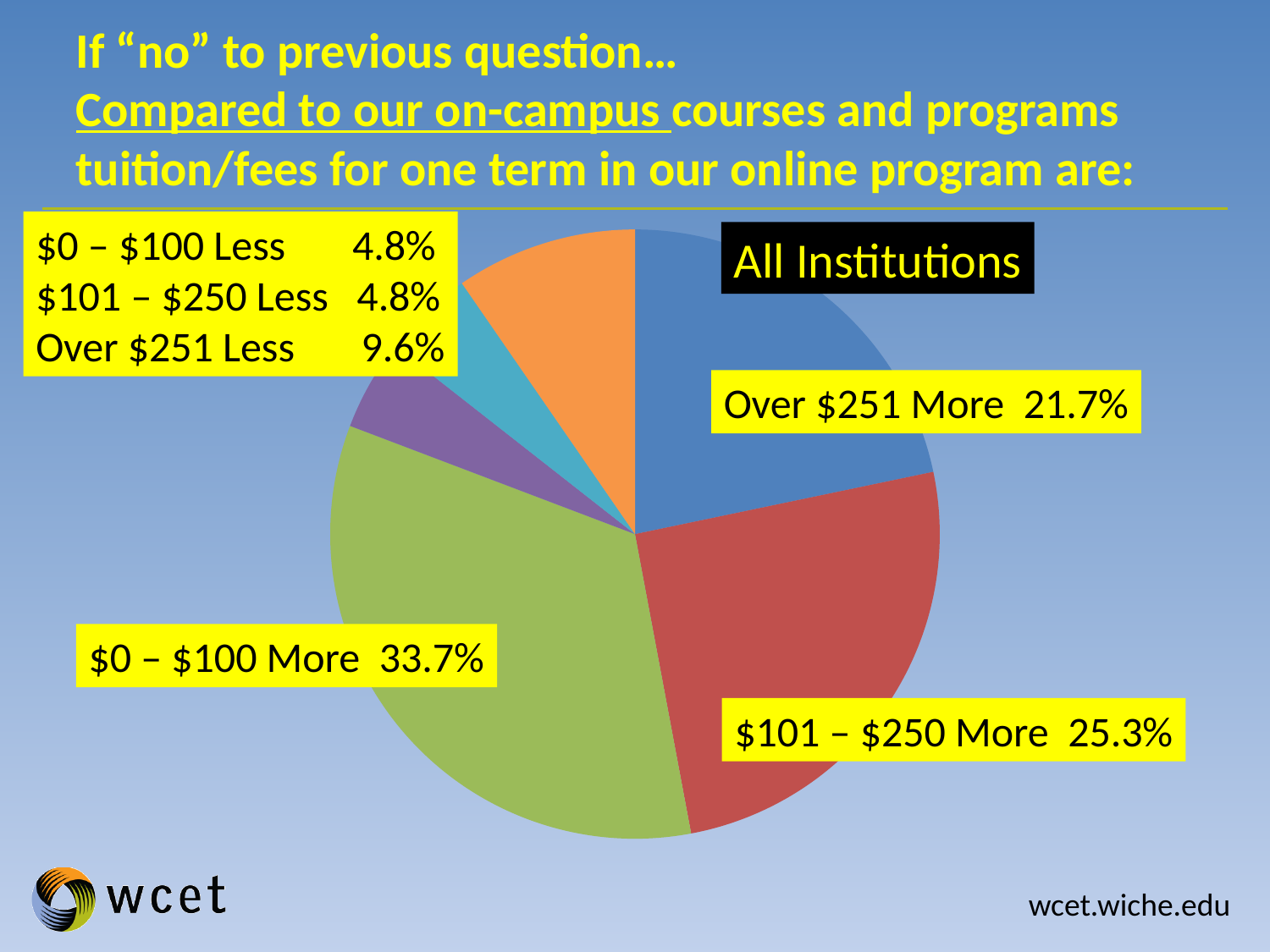
How many categories are shown in the pie chart? 6 What type of chart is shown on the slide? Pie chart What percentage is listed for Over $251 Less? 9.6% What is the difference in percentage points between Over $251 More and Over $251 Less? 12.1 What share of the pie is labelled $0 – $100 More? 33.7% How many percentage points larger is $0 – $100 More than $101 – $250 More? 8.4 Which is larger, Over $251 More or Over $251 Less? Over $251 More What is the value shown for $101 – $250 More? 25.3% Which category has the largest share of the pie? $0 – $100 More What is the combined percentage of the three 'More' categories (Over $251 More, $101 – $250 More and $0 – $100 More)? 80.7% What percentage of institutions reported online tuition/fees are Over $251 More than on-campus? 21.7% Which two categories share the smallest value of 4.8%? $0 – $100 Less and $101 – $250 Less